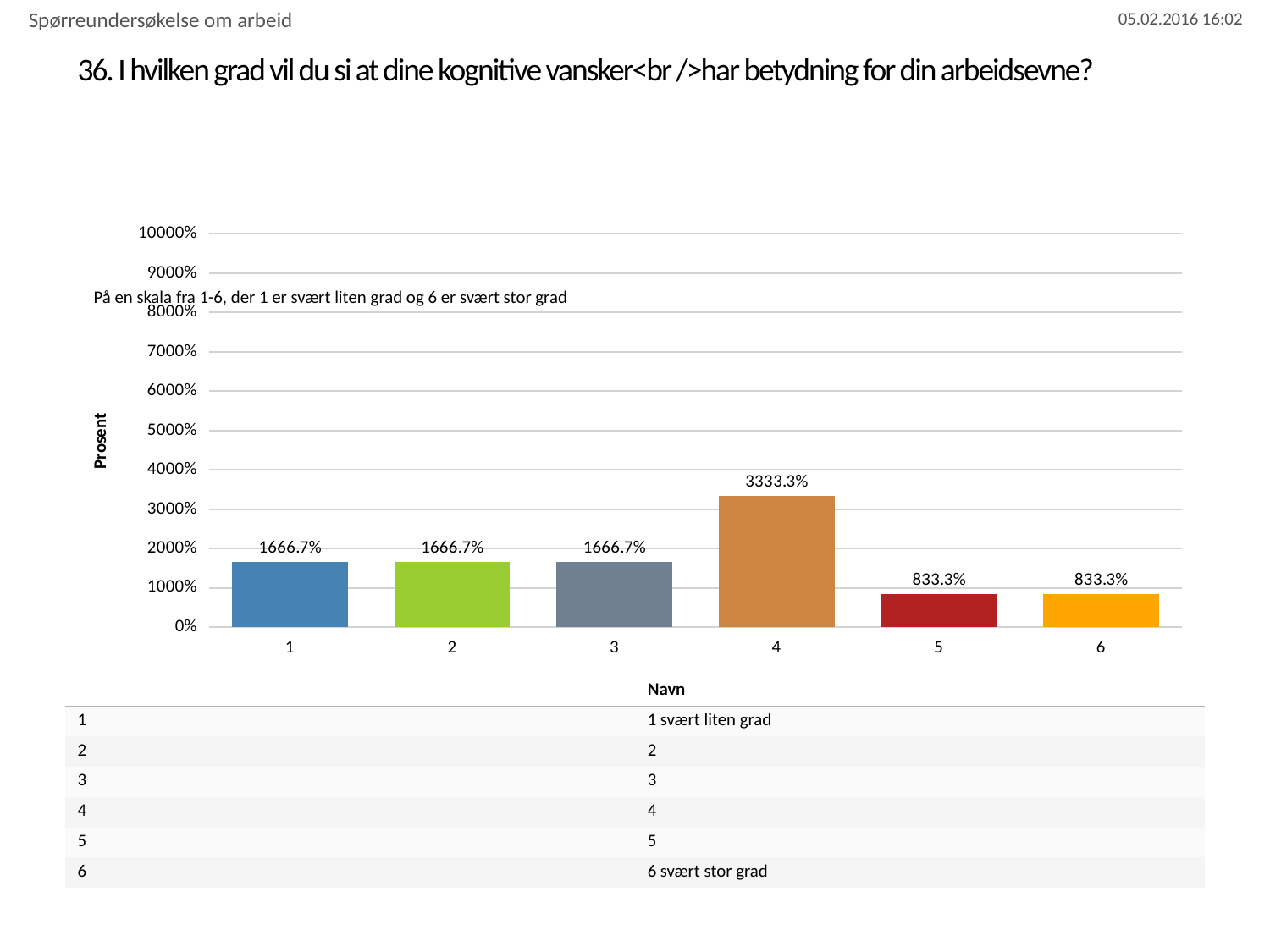
Which is larger, the value for category 4 or the value for category 5? 4 Is the value for category 4 greater or less than 3000%? greater What is the value for category 1? 1666.7% What is the value for category 4? 3333.3% What is the value for category 5? 833.3% What is the difference between the values for category 4 and category 3? 1666.6% What kind of chart is shown on the slide? bar chart What is the label of the y axis? Prosent Is the value for category 6 greater or less than 1000%? less What is the difference between the values for category 2 and category 6? 833.4% How many categories are shown on the x axis? 6 Which category has the highest value? 4